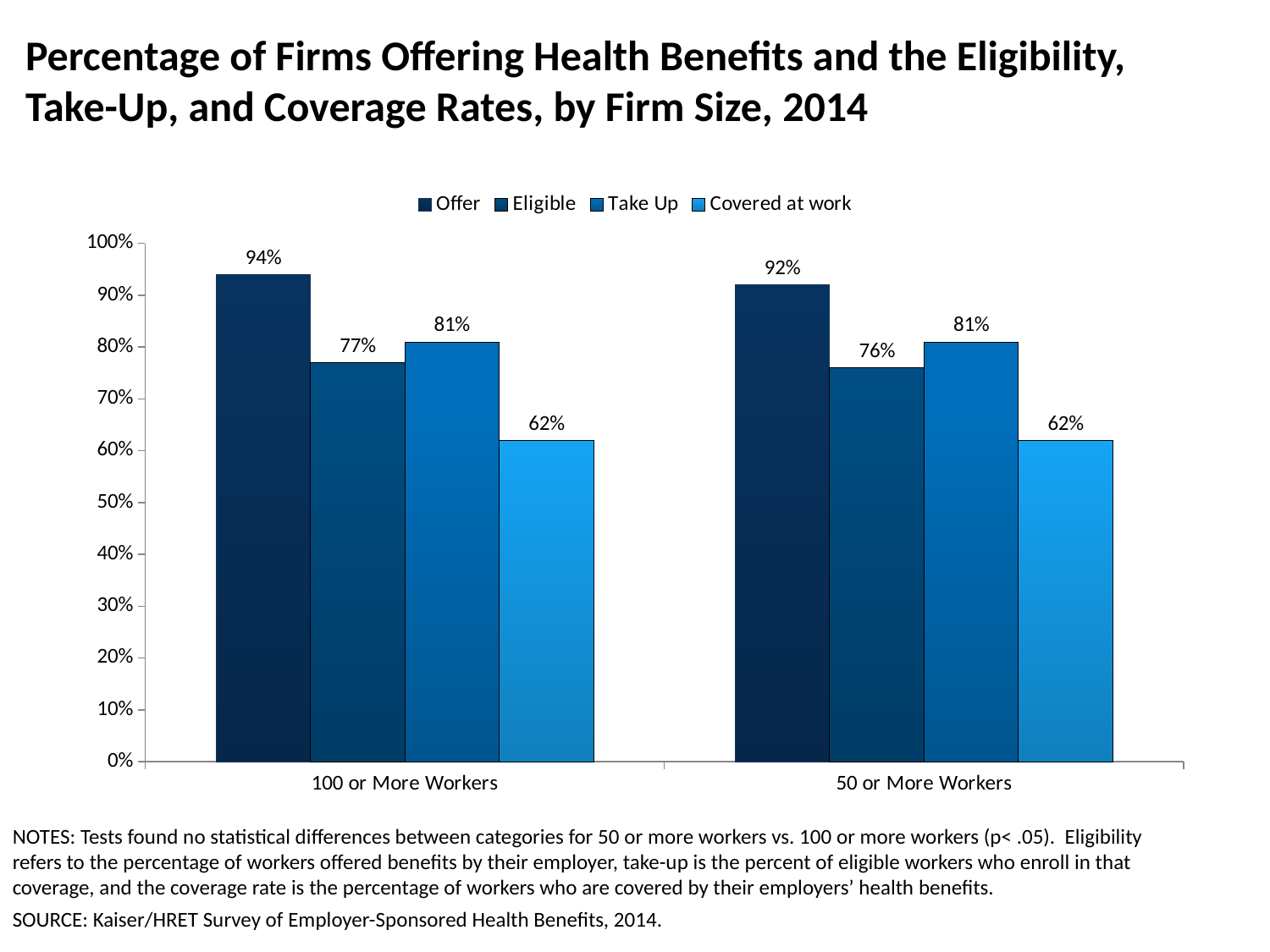
What is the difference between the Offer value and the Covered at work value for 100 or More Workers? 32% What is the source cited for the chart? Kaiser/HRET Survey of Employer-Sponsored Health Benefits, 2014 Which series has the lowest value for 100 or More Workers? Covered at work What is the Eligible value for 50 or More Workers? 76% What is the Offer value for 100 or More Workers? 94% Which series has the highest value for 50 or More Workers? Offer What is the Take Up value for 100 or More Workers? 81% How many firm-size categories are shown on the x axis? 2 Which is larger, the Offer value for 100 or More Workers or the Offer value for 50 or More Workers? 100 or More Workers What kind of chart is shown on the slide? Bar chart How many series does the legend list? 4 What is the Covered at work value for 50 or More Workers? 62%